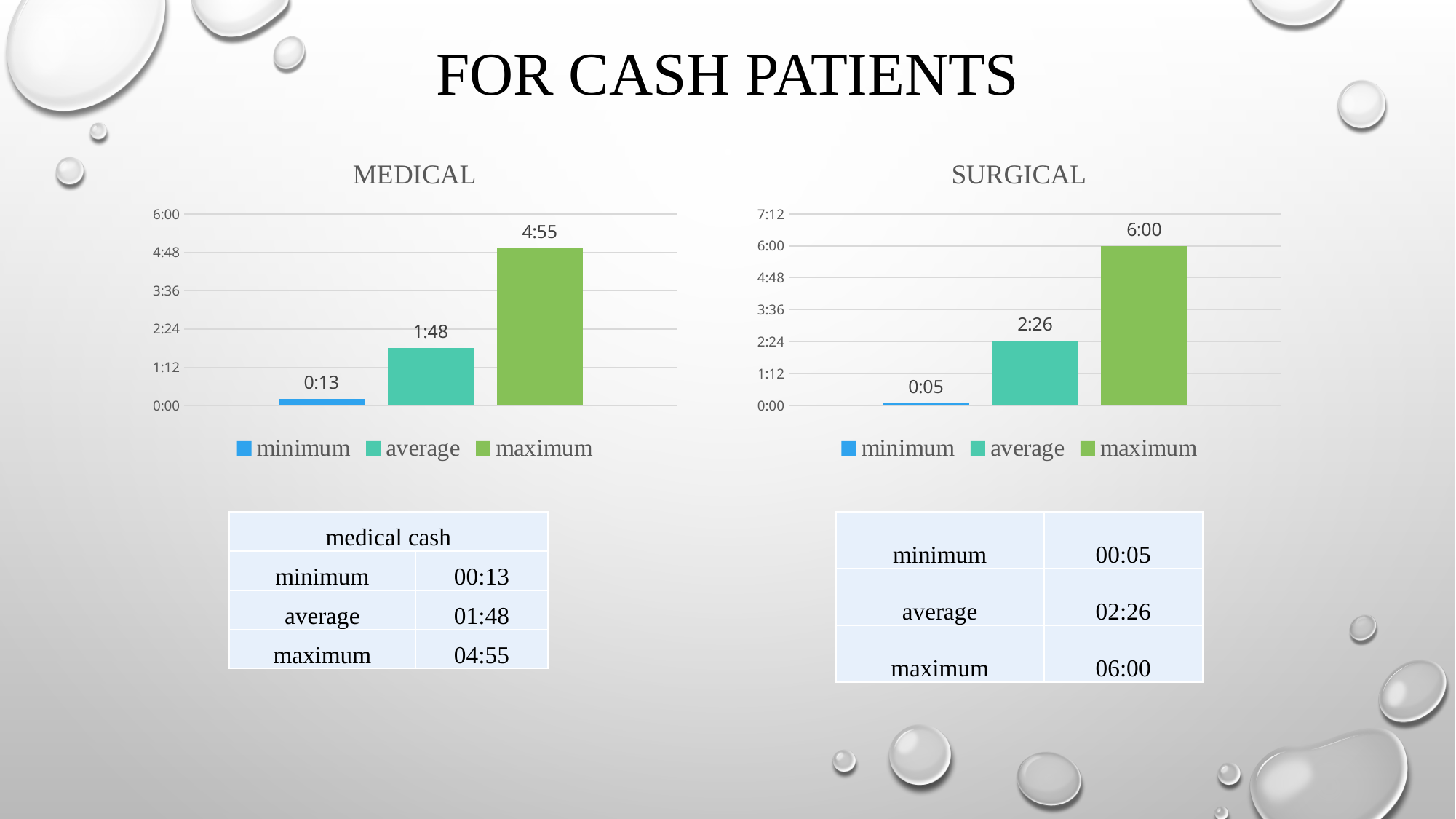
In the MEDICAL chart, which series has the lowest value? minimum In the SURGICAL chart, what is the value of the minimum bar? 0:05 Which is larger: the maximum value in the MEDICAL chart or the maximum value in the SURGICAL chart? SURGICAL In the SURGICAL chart, which series has the highest value? maximum In the MEDICAL chart, is the value of the average bar greater or less than 2:24? less How many series does the legend of the MEDICAL chart list? 3 What type of chart is the SURGICAL chart? bar chart In the SURGICAL chart, is the value of the maximum bar greater or less than 4:48? greater In the MEDICAL chart, what is the value of the average bar? 1:48 What colour is the maximum series in the MEDICAL chart? green In the MEDICAL chart, what is the value of the maximum bar? 4:55 In the SURGICAL chart, what is the value of the average bar? 2:26